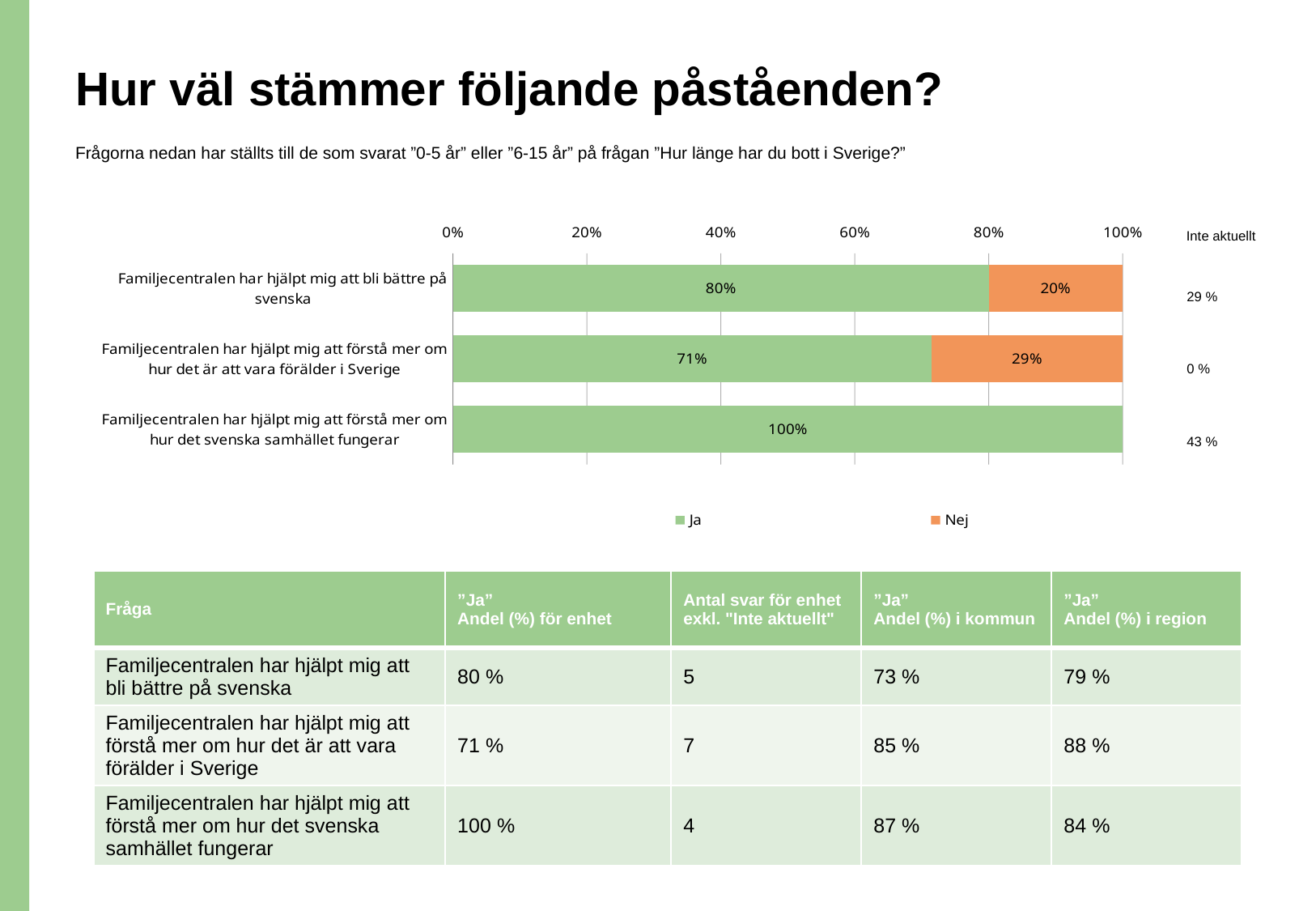
What is the "Ja" value for "Familjecentralen har hjälpt mig att förstå mer om hur det svenska samhället fungerar"? 100% How many series does the chart legend list? 2 What are the two series named in the chart legend? Ja and Nej Which is larger: the "Nej" value for "bli bättre på svenska" or the "Nej" value for "vara förälder i Sverige"? Nej for vara förälder i Sverige (29%) How many categories (statements) are shown in the chart? 3 What is the "Nej" value for "Familjecentralen har hjälpt mig att förstå mer om hur det är att vara förälder i Sverige"? 29% What is the total of the stacked bar for "Familjecentralen har hjälpt mig att bli bättre på svenska"? 100% What is the "Ja" value for "Familjecentralen har hjälpt mig att bli bättre på svenska"? 80% What kind of chart is shown on the slide? Stacked bar chart Which category has the highest "Ja" value? Familjecentralen har hjälpt mig att förstå mer om hur det svenska samhället fungerar Which category has the lowest "Ja" value? Familjecentralen har hjälpt mig att förstå mer om hur det är att vara förälder i Sverige What is the difference between the "Ja" values for "bli bättre på svenska" and "vara förälder i Sverige"? 9%